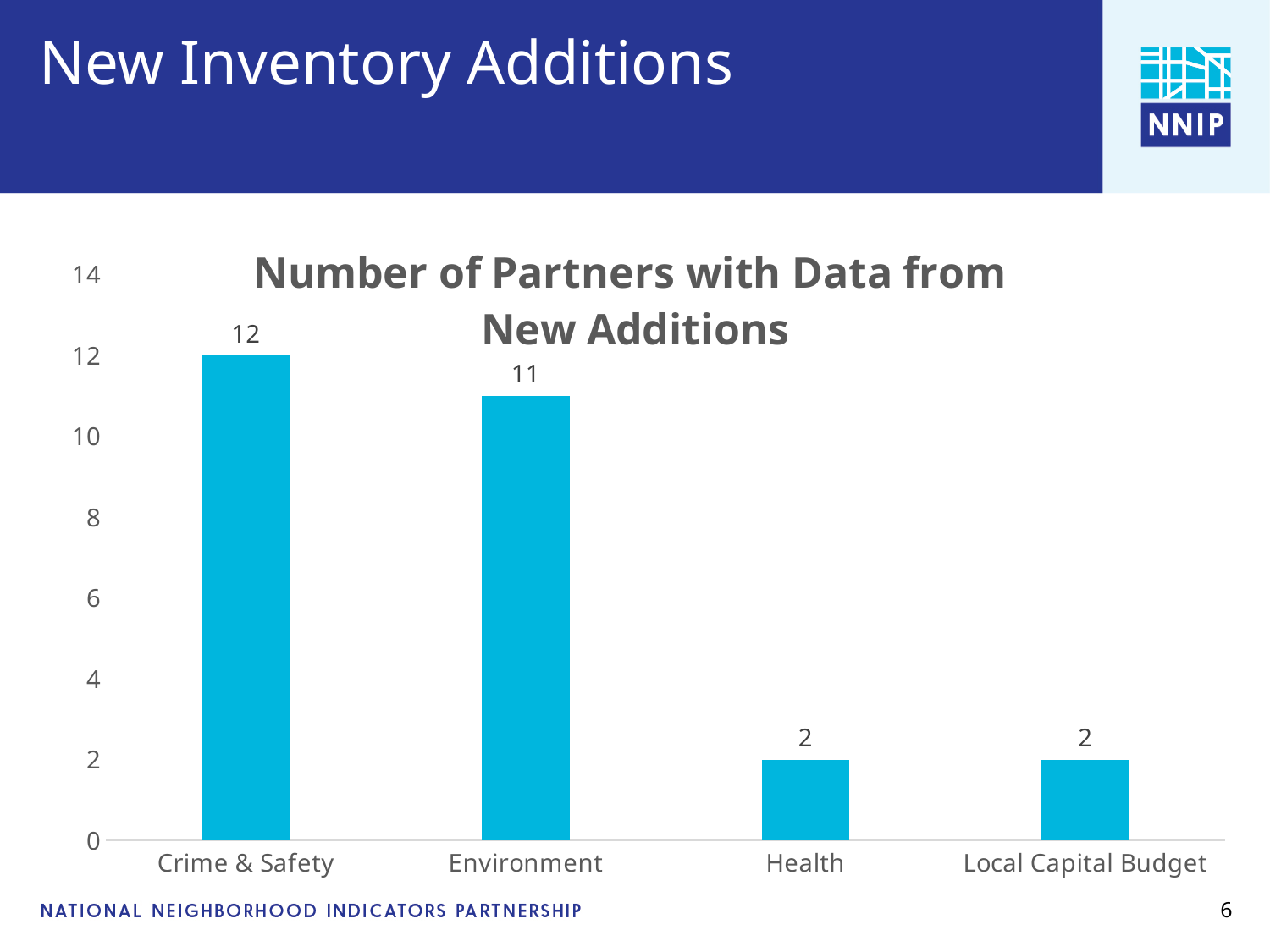
What is the number of partners with data for Local Capital Budget? 2 What is the difference between the values for Environment and Health? 9 Which category has the highest number of partners? Crime & Safety What is the number of partners with data for Health? 2 How many categories are shown on the x axis? 4 What is the number of partners with data for Environment? 11 What kind of chart is shown on the slide? Bar chart What is the difference between the values for Crime & Safety and Environment? 1 Which is larger, the value for Crime & Safety or the value for Environment? Crime & Safety What is the title of the chart? Number of Partners with Data from New Additions What is the number of partners with data for Crime & Safety? 12 Is the value for Environment greater or less than 10? greater